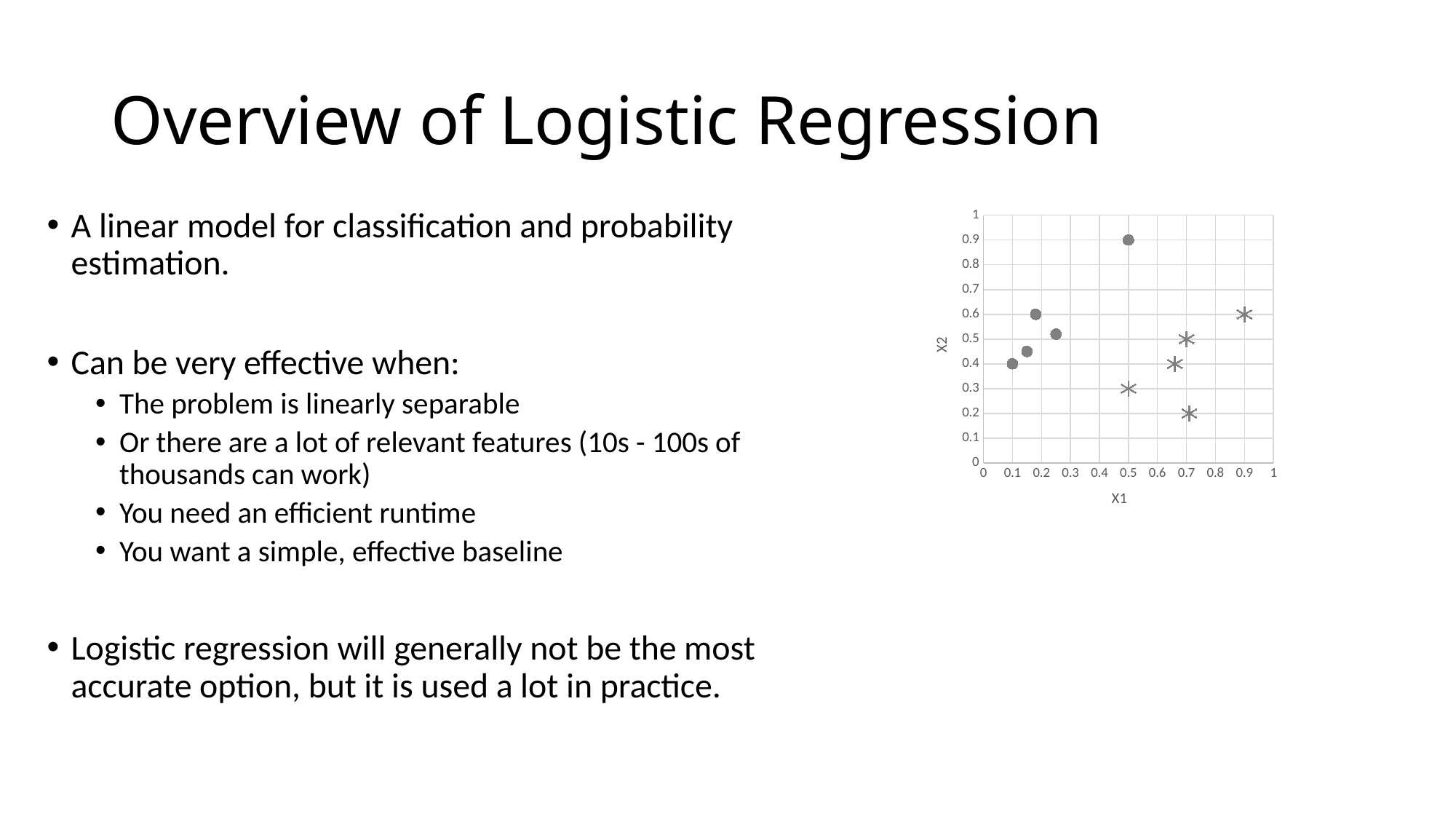
Which marker type, circle or asterisk, contains the point with the largest X1 value? asterisk What kind of chart is shown on the slide? scatter chart Is the X1 value of the rightmost asterisk marker greater or less than 0.8? greater How many circle markers are plotted in the chart? 5 How many data points are plotted in the chart in total? 10 How many distinct marker types (series) are plotted in the chart? 2 What is the label of the horizontal axis of the chart? X1 What is the label of the vertical axis of the chart? X2 Is the X2 value of the highest circle marker greater or less than 0.8? greater How many asterisk markers are plotted in the chart? 5 Which marker type, circle or asterisk, contains the point with the highest X2 value? circle Is the X2 value of the lowest asterisk marker greater or less than 0.3? less